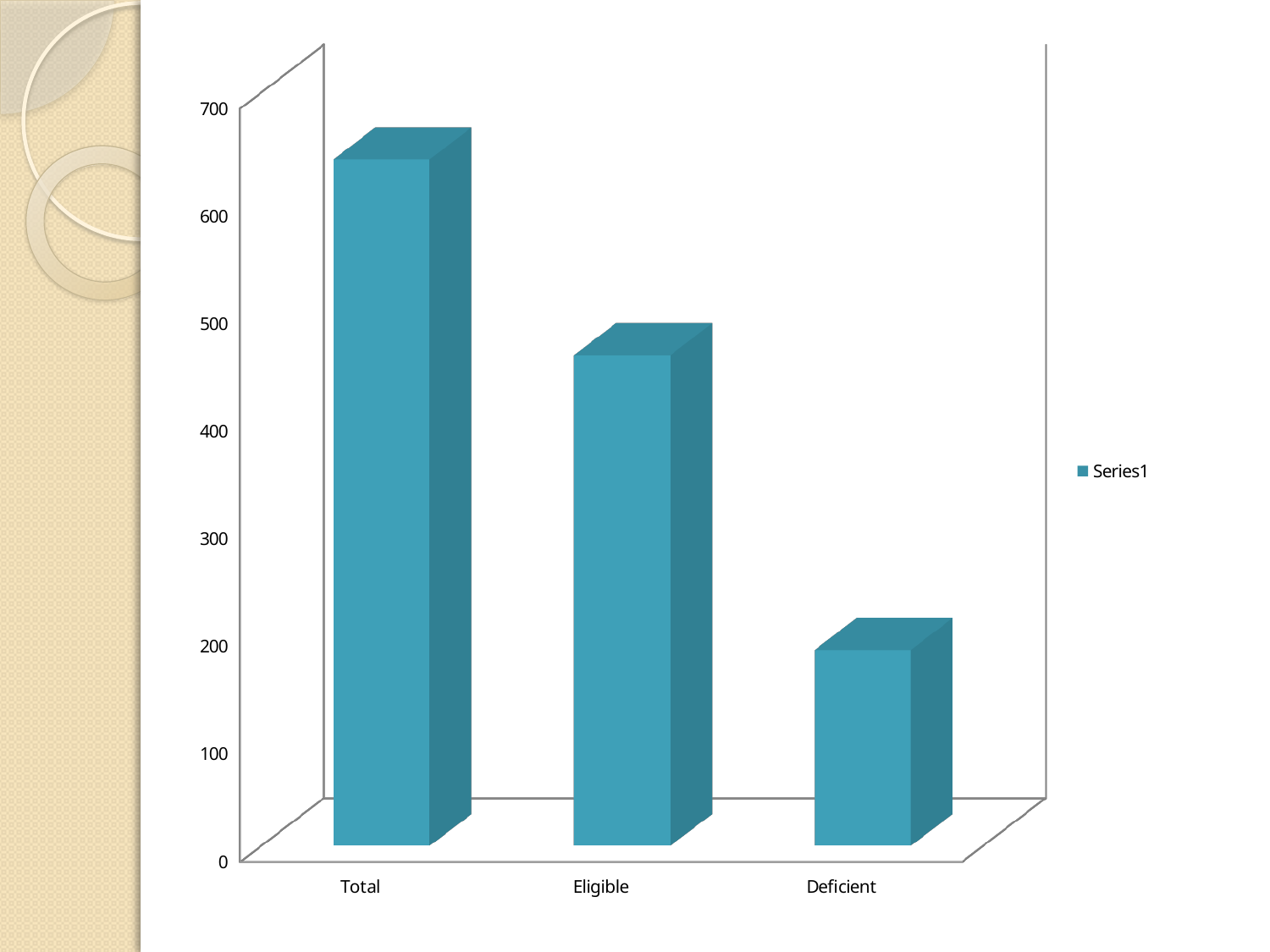
Is the value for Deficient greater or less than 300? less Is the value for Eligible greater or less than 500? less Is the value for Total greater or less than 600? greater How many series does the legend list? 1 Which is larger, the value for Eligible or the value for Deficient? Eligible How many categories are shown on the x axis of the chart? 3 Which category has the lowest bar? Deficient Do the bar values rise or fall from left to right along the x axis? fall Which category has the highest bar? Total What kind of chart is shown on the slide? bar chart What is the name of the series shown in the legend? Series1